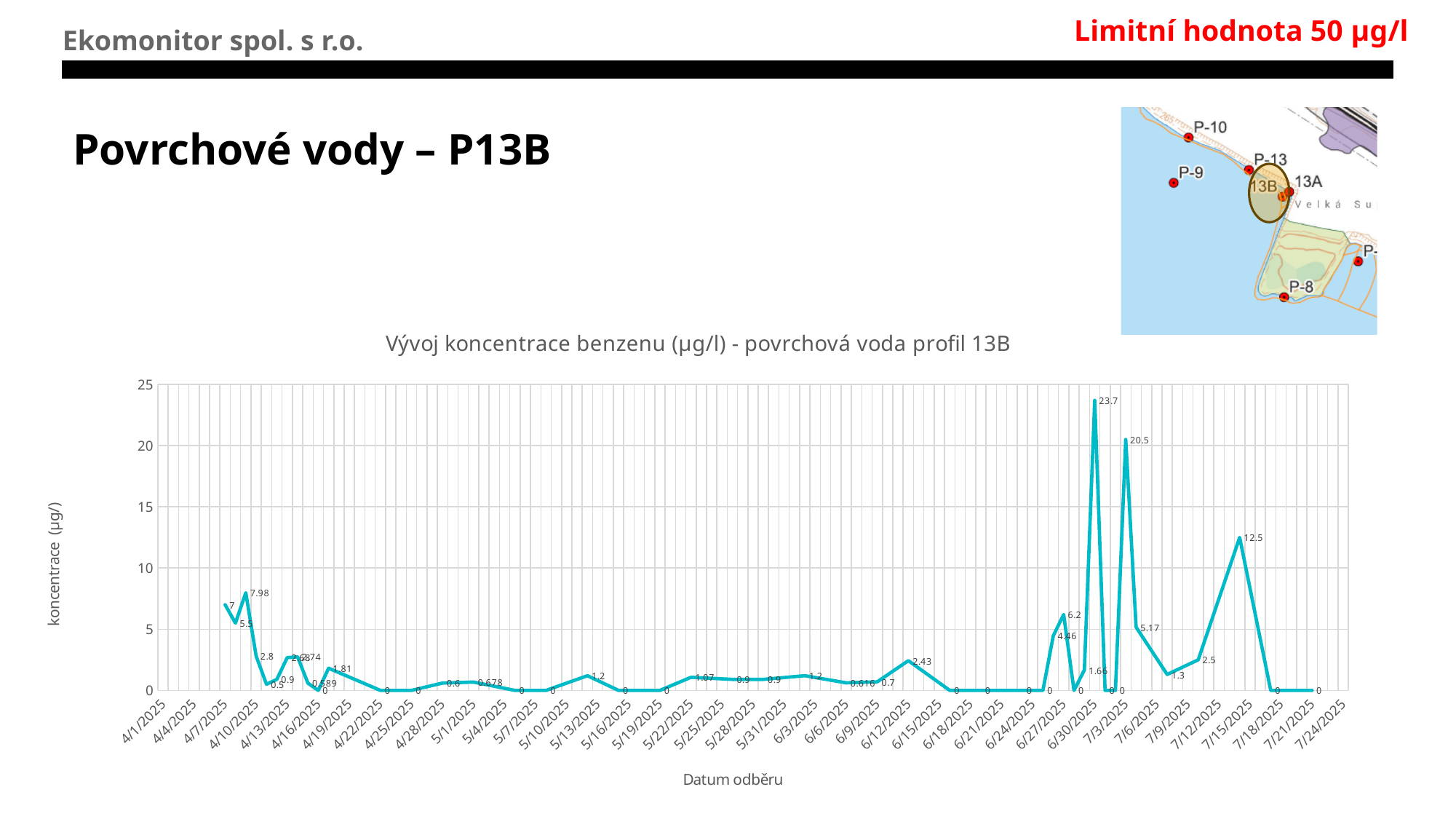
What is the title of the chart? Vývoj koncentrace benzenu (µg/l) - povrchová voda profil 13B What kind of chart is shown on the slide? line chart Is the highest value on the chart greater or less than 20? greater What is the first labeled value at the start of the series in early April? 7 What is the value of the peak in mid-July (around 7/15/2025)? 12.5 What is the lowest value labeled on the chart? 0 What is the second-highest peak value labeled on the chart, in early July? 20.5 Which is larger: the early-April peak of 7.98 or the late-June peak of 6.2? 7.98 What is the label of the vertical axis? koncentrace (µg/l) What is the highest benzene concentration value labeled on the chart? 23.7 What is the difference between the two highest labeled peaks, 23.7 and 20.5? 3.2 Is the highest value on the chart greater or less than 25? less